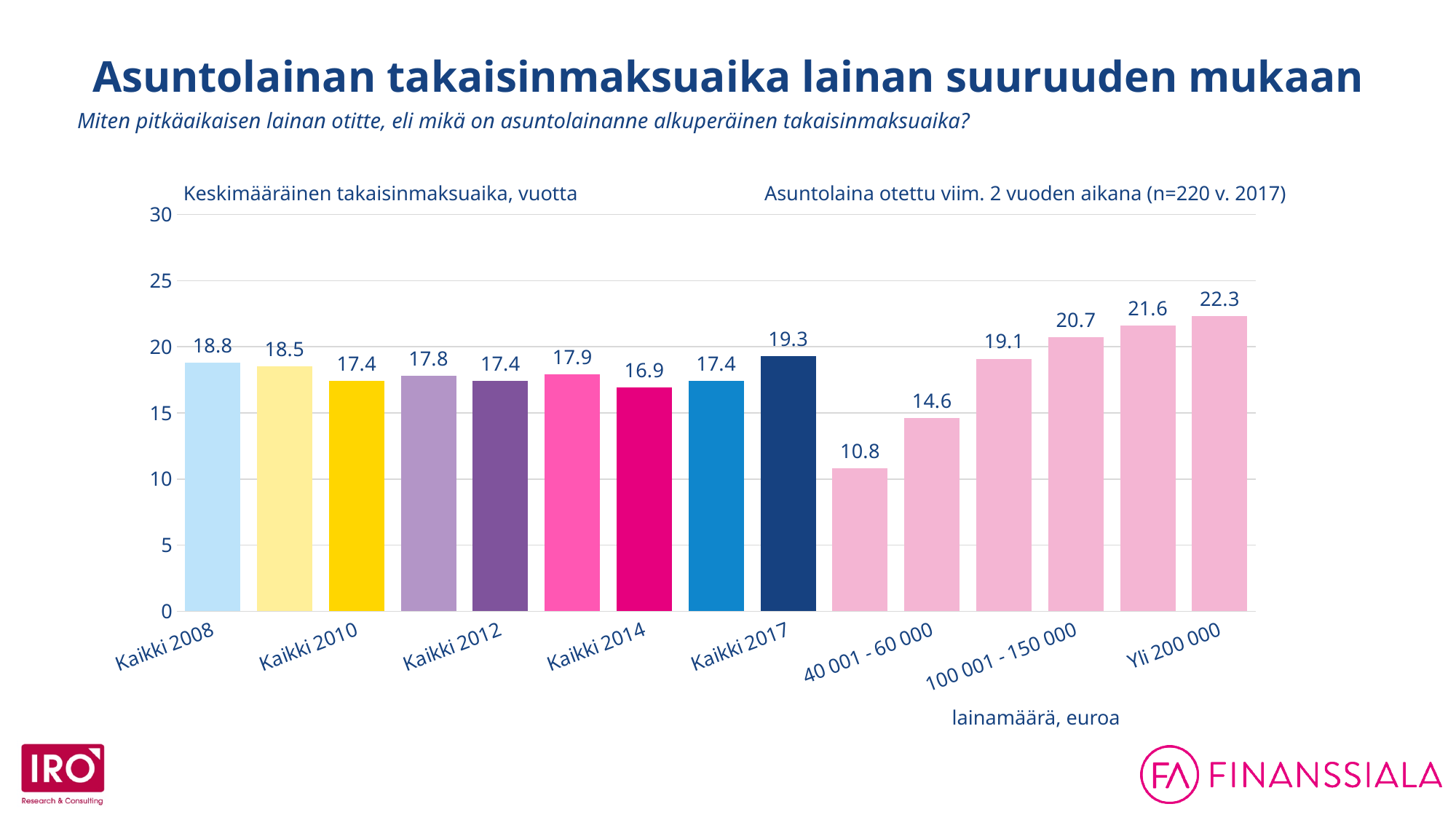
Which is larger, the value for Kaikki 2008 or Kaikki 2010? Kaikki 2008 What is the difference between the values for Yli 200 000 and Kaikki 2017? 3.0 What is the average repayment period for Kaikki 2008? 18.8 Do the values rise or fall across the loan size categories from 40 001 - 60 000 to Yli 200 000? rise What is the value for Kaikki 2017? 19.3 Is the value for 40 001 - 60 000 greater or less than 15? less What is the value for the loan size category 100 001 - 150 000? 20.7 What kind of chart is shown on the slide? bar chart What is the lowest value shown on the chart? 10.8 How many bars are shown on the chart? 15 Which labelled category has the highest value? Yli 200 000 What is the value for the loan size category 40 001 - 60 000? 14.6